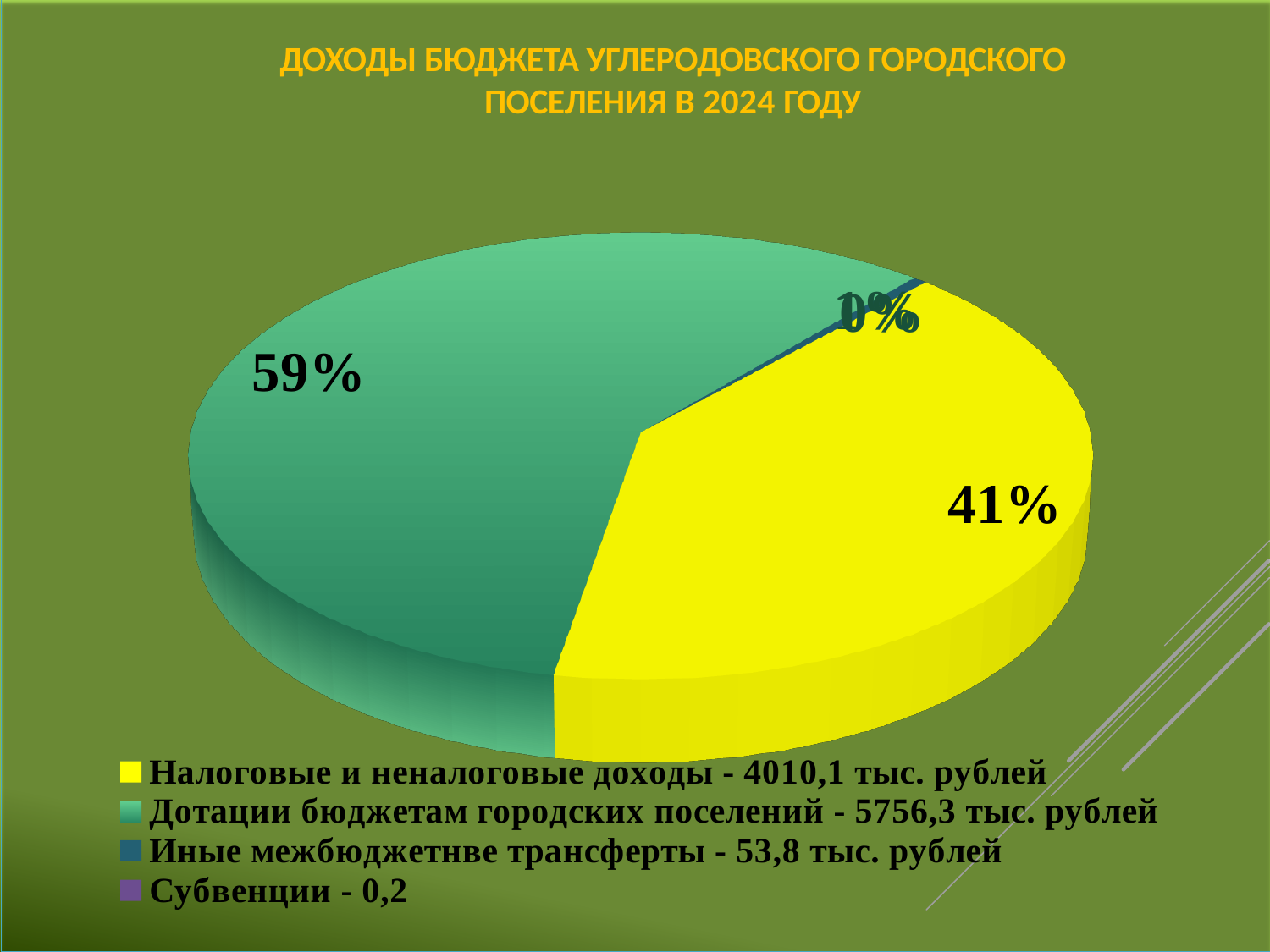
Which is larger: the amount for Дотации бюджетам городских поселений or the amount for Налоговые и неналоговые доходы? Дотации бюджетам городских поселений What is the difference between the amounts for Дотации бюджетам городских поселений and Налоговые и неналоговые доходы, in тыс. рублей? 1746,2 What amount is given in the legend for Налоговые и неналоговые доходы? 4010,1 тыс. рублей Which category has the largest slice of the pie? Дотации бюджетам городских поселений What colour is the slice for Налоговые и неналоговые доходы? yellow What share of the pie does the slice for Налоговые и неналоговые доходы take? 41% What amount is given in the legend for Дотации бюджетам городских поселений? 5756,3 тыс. рублей What amount is given in the legend for Иные межбюджетнве трансферты? 53,8 тыс. рублей What share of the pie does the slice for Дотации бюджетам городских поселений take? 59% What kind of chart is shown on the slide? pie chart What value is given in the legend for Субвенции? 0,2 How many entries does the legend list? 4